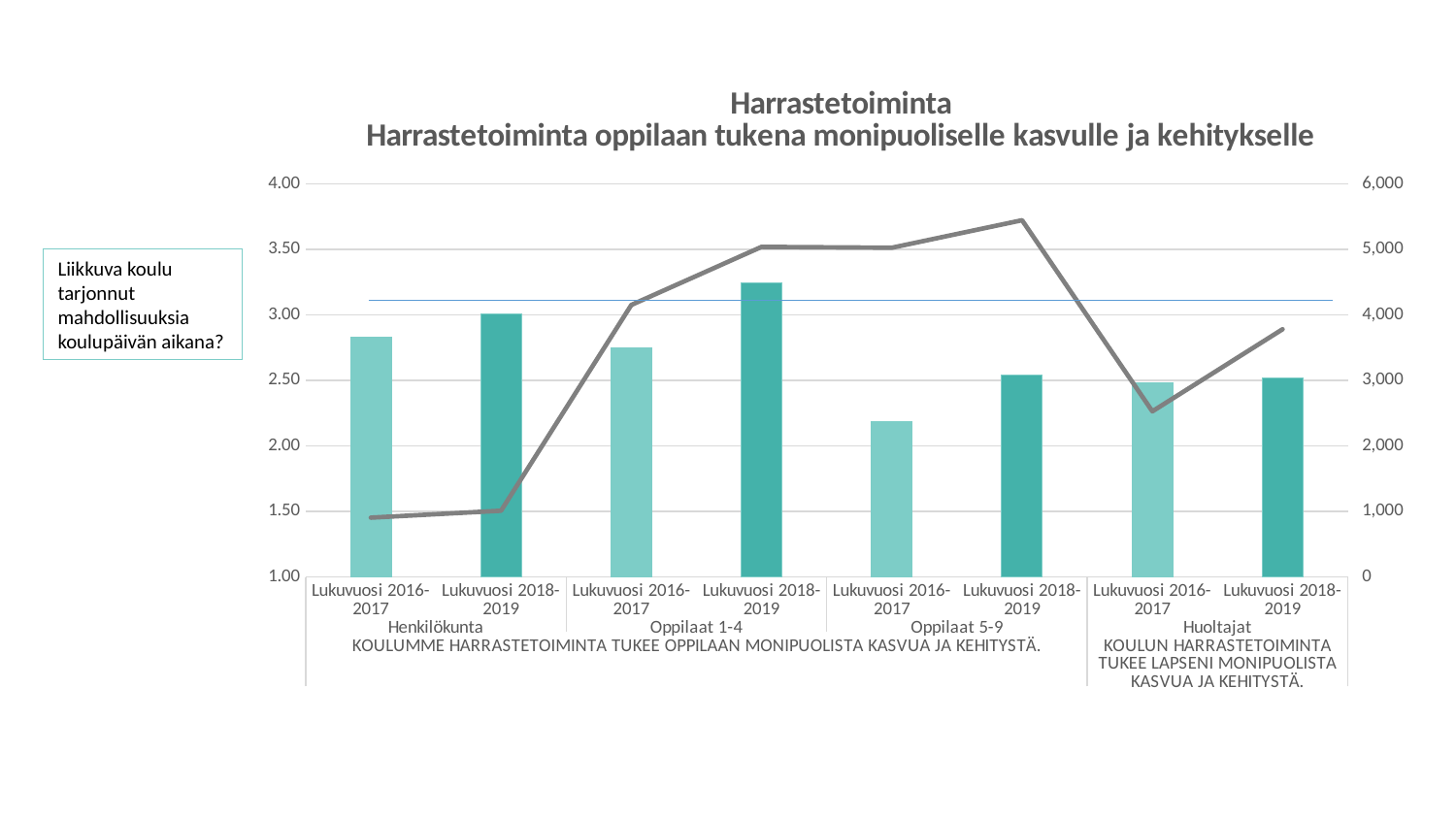
For Henkilökunta, which bar is taller: Lukuvuosi 2016-2017 or Lukuvuosi 2018-2019? Lukuvuosi 2018-2019 What is the first line of the chart title? Harrastetoiminta Which bar is the highest in the chart? Oppilaat 1-4, Lukuvuosi 2018-2019 How many bars are plotted in the chart? 8 Is the bar value for Oppilaat 1-4 in Lukuvuosi 2018-2019 greater or less than 3.00? greater Which bar is the lowest in the chart? Oppilaat 5-9, Lukuvuosi 2016-2017 For Oppilaat 5-9, which bar is taller: Lukuvuosi 2016-2017 or Lukuvuosi 2018-2019? Lukuvuosi 2018-2019 Is the line value for Oppilaat 5-9 in Lukuvuosi 2018-2019 greater or less than 5,000 on the right-hand axis? greater Is the bar value for Henkilökunta in Lukuvuosi 2016-2017 greater or less than 3.00? less At which category does the line reach its highest point? Oppilaat 5-9, Lukuvuosi 2018-2019 What kind of chart is shown on the slide? A bar chart combined with a line